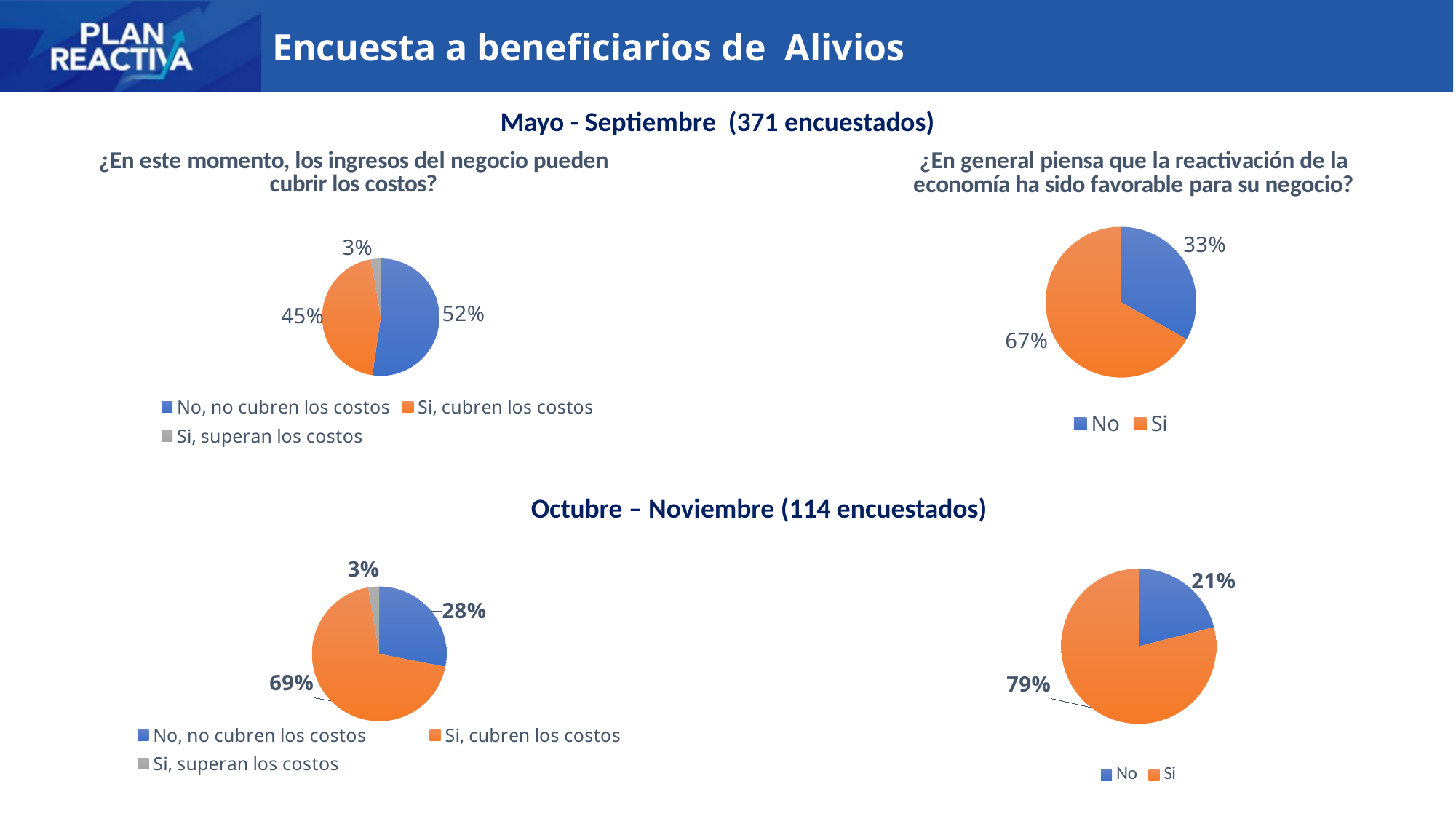
In the top-left pie chart (Mayo - Septiembre, ingresos cubren los costos), what percentage is shown for 'No, no cubren los costos'? 52% In the top-right pie chart (Mayo - Septiembre, reactivación favorable), what percentage answered 'Si'? 67% In the bottom-left pie chart (Octubre - Noviembre, ingresos cubren los costos), which category has the smallest share? Si, superan los costos In the bottom-left pie chart (Octubre - Noviembre, ingresos cubren los costos), how many categories does the legend list? 3 In the top-left pie chart (Mayo - Septiembre, ingresos cubren los costos), what percentage is shown for 'Si, superan los costos'? 3% In the bottom-left pie chart (Octubre - Noviembre, ingresos cubren los costos), what percentage is shown for 'Si, cubren los costos'? 69% In the bottom-right pie chart (Octubre - Noviembre, reactivación favorable), what percentage answered 'No'? 21% In the top-left pie chart (Mayo - Septiembre, ingresos cubren los costos), which category has the largest share? No, no cubren los costos In the top-right pie chart (Mayo - Septiembre, reactivación favorable), what is the difference between the 'Si' and 'No' shares? 34% In the bottom-right pie chart (Octubre - Noviembre, reactivación favorable), which answer is larger, 'No' or 'Si'? Si What type of chart is used for the four charts on this slide? Pie chart How many charts are shown on the slide? 4